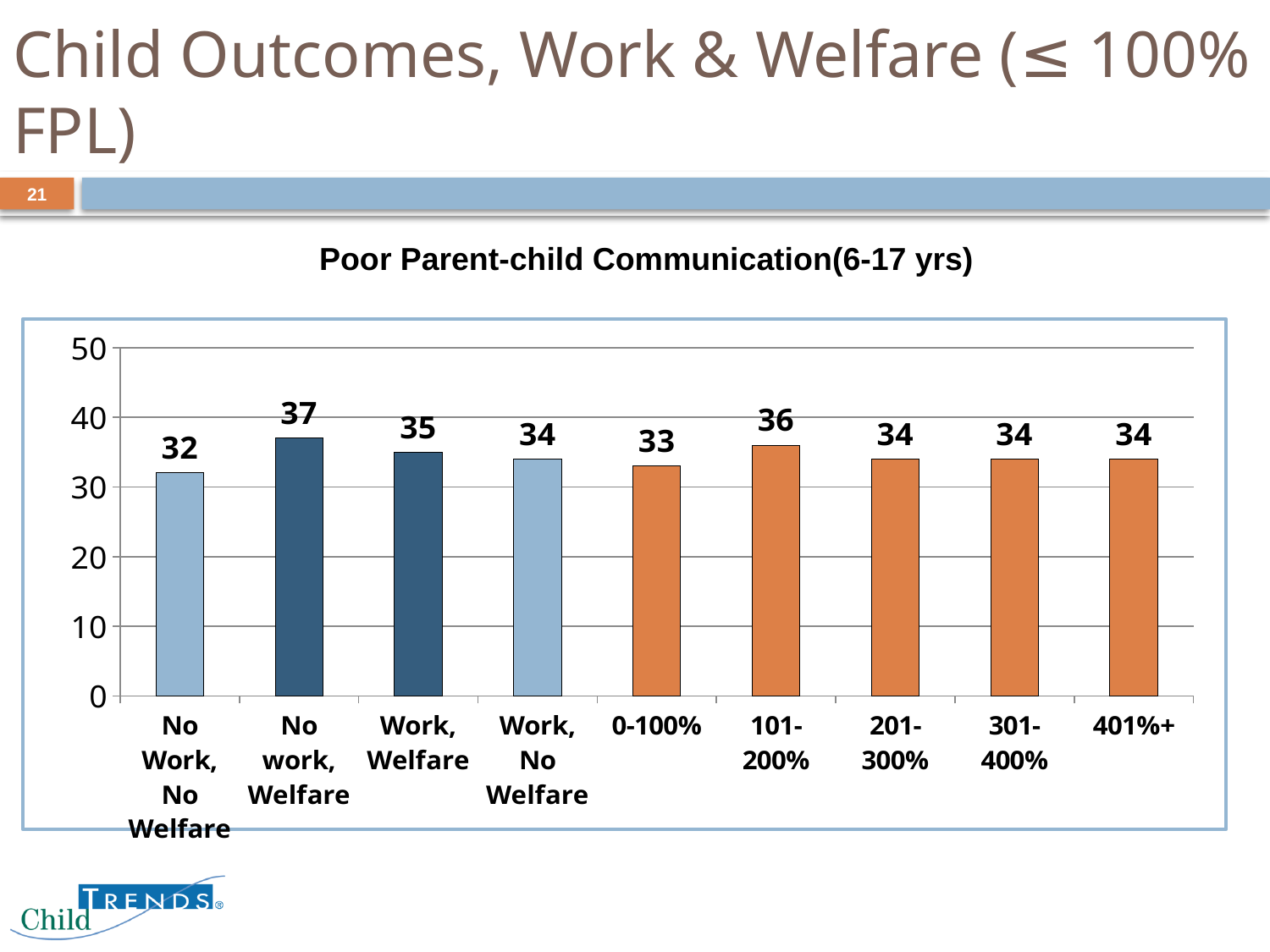
Which category has the lowest value? No Work, No Welfare What is the value for '101-200%'? 36 What is the value for the '0-100%' category? 33 How many categories are shown on the x axis? 9 Which category has the highest value? No work, Welfare What is the value for 'No Work, No Welfare'? 32 What kind of chart is shown? bar chart What is the difference between the values for 'No work, Welfare' and 'No Work, No Welfare'? 5 Is the value for '401%+' greater or less than 30? greater What is the value for 'No work, Welfare'? 37 Which is larger, the value for 'Work, Welfare' or the value for '0-100%'? Work, Welfare What is the title of the chart? Poor Parent-child Communication(6-17 yrs)